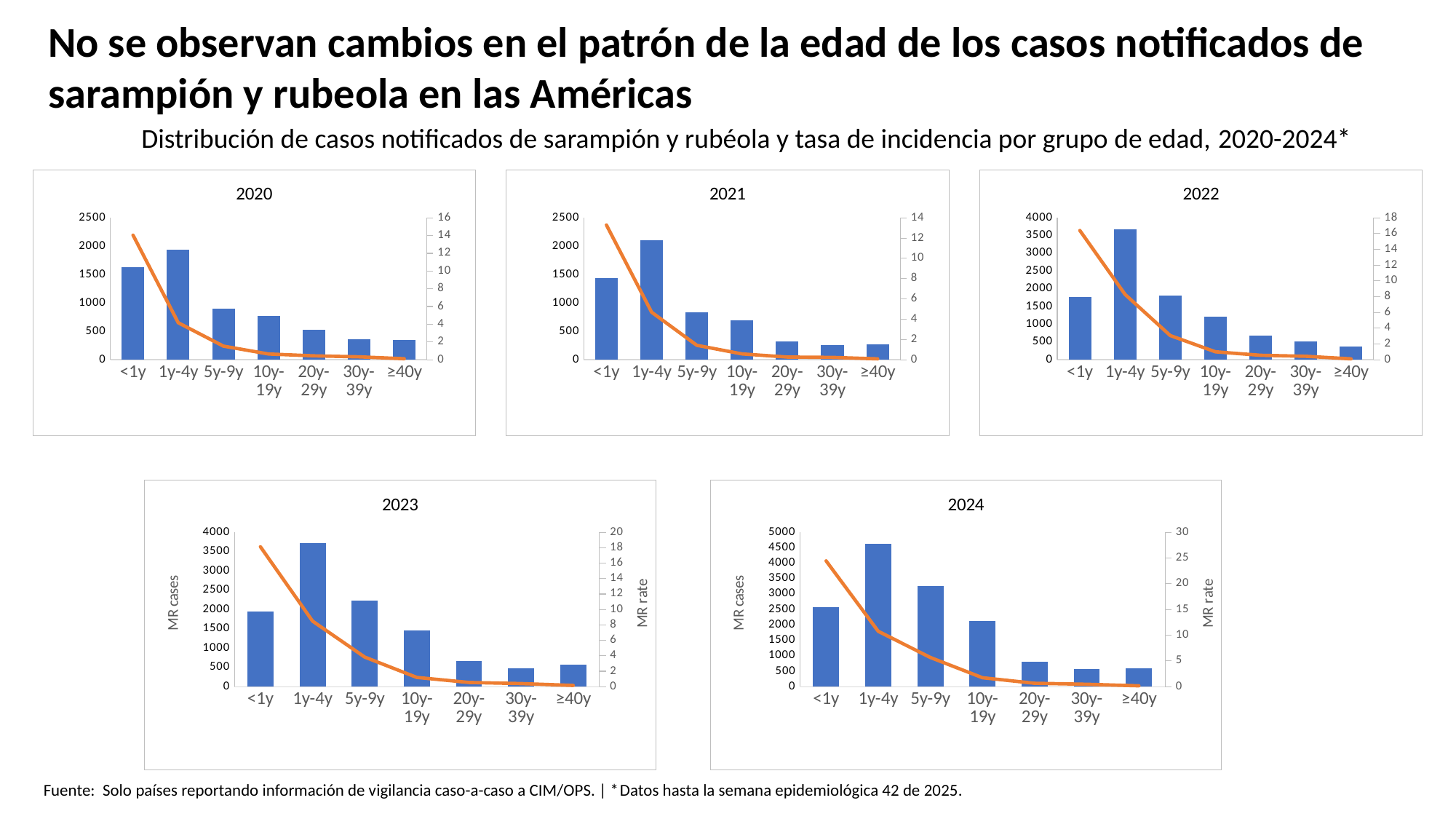
In the 2024 chart, is the number of cases for 1y-4y greater or less than 4000? greater In the 2024 chart, does the orange MR rate line rise or fall across the age groups from <1y to ≥40y? fall In the 2022 chart, is the number of cases for 1y-4y greater or less than 3500? greater In the 2020 chart, which age group has the highest number of cases? 1y-4y In the 2021 chart, which has more cases, <1y or 5y-9y? <1y In the 2022 chart, which age group has the lowest number of cases? ≥40y In the 2024 chart, which age group has the highest number of cases? 1y-4y In the 2020 chart, is the number of cases for <1y greater or less than 1500? greater How many charts are shown on the slide? 5 How many age groups are shown on the x axis of the 2023 chart? 7 In the 2023 chart, which has more cases, <1y or 5y-9y? 5y-9y